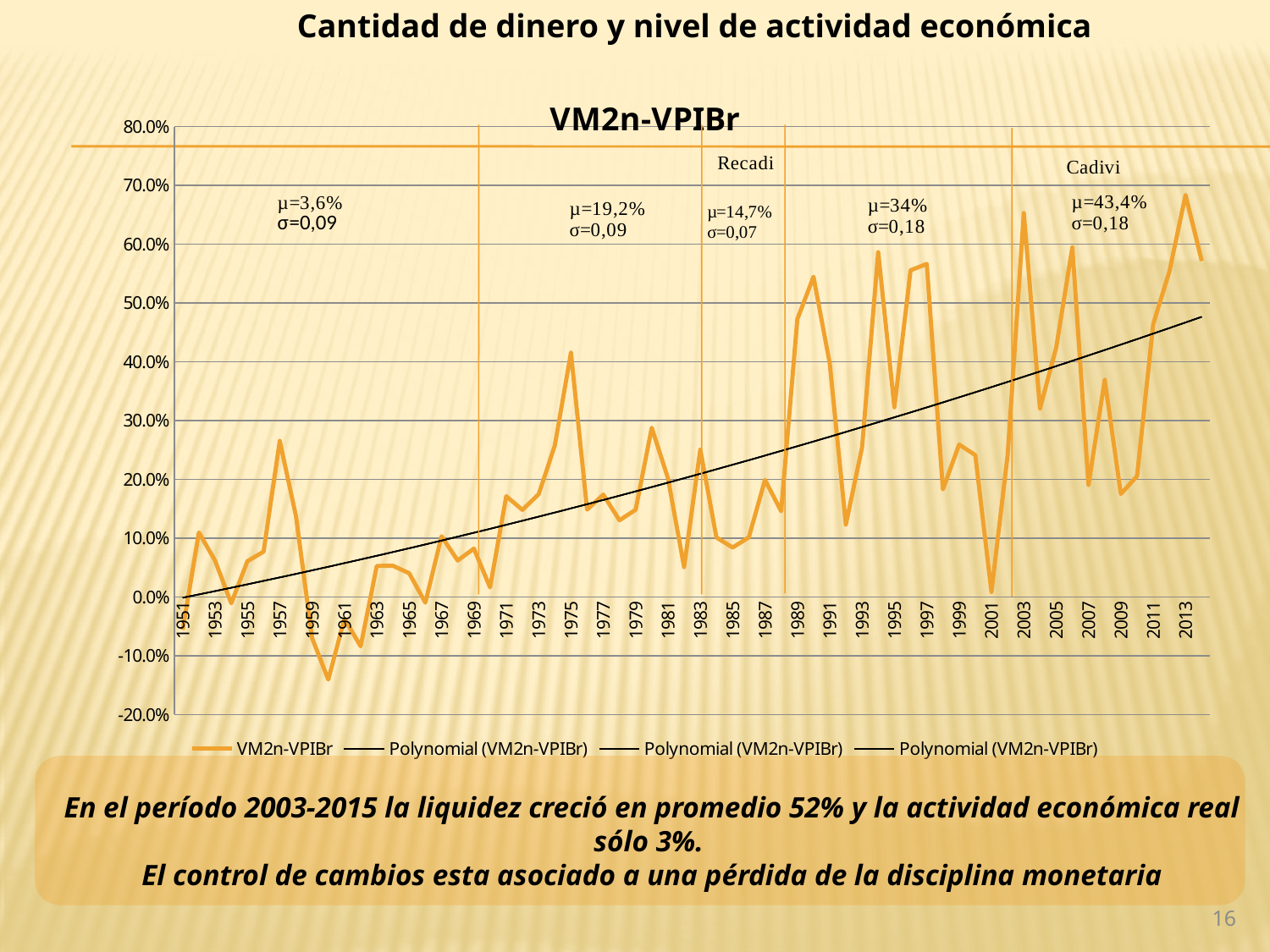
Is the value for 1993 greater or less than 50%? less Is the value for 2013 greater or less than 60%? greater Is the value for 1957 greater or less than 20%? greater Does the black polynomial trend line rise or fall from 1951 to 2013? rise What is the title of the chart? VM2n-VPIBr What is the highest value shown on the y axis? 80.0% What kind of chart is shown on the slide? line chart How many year labels are shown on the x axis? 32 How many series does the legend list? 4 Which is larger, the value for 1975 or the value for 1977? 1975